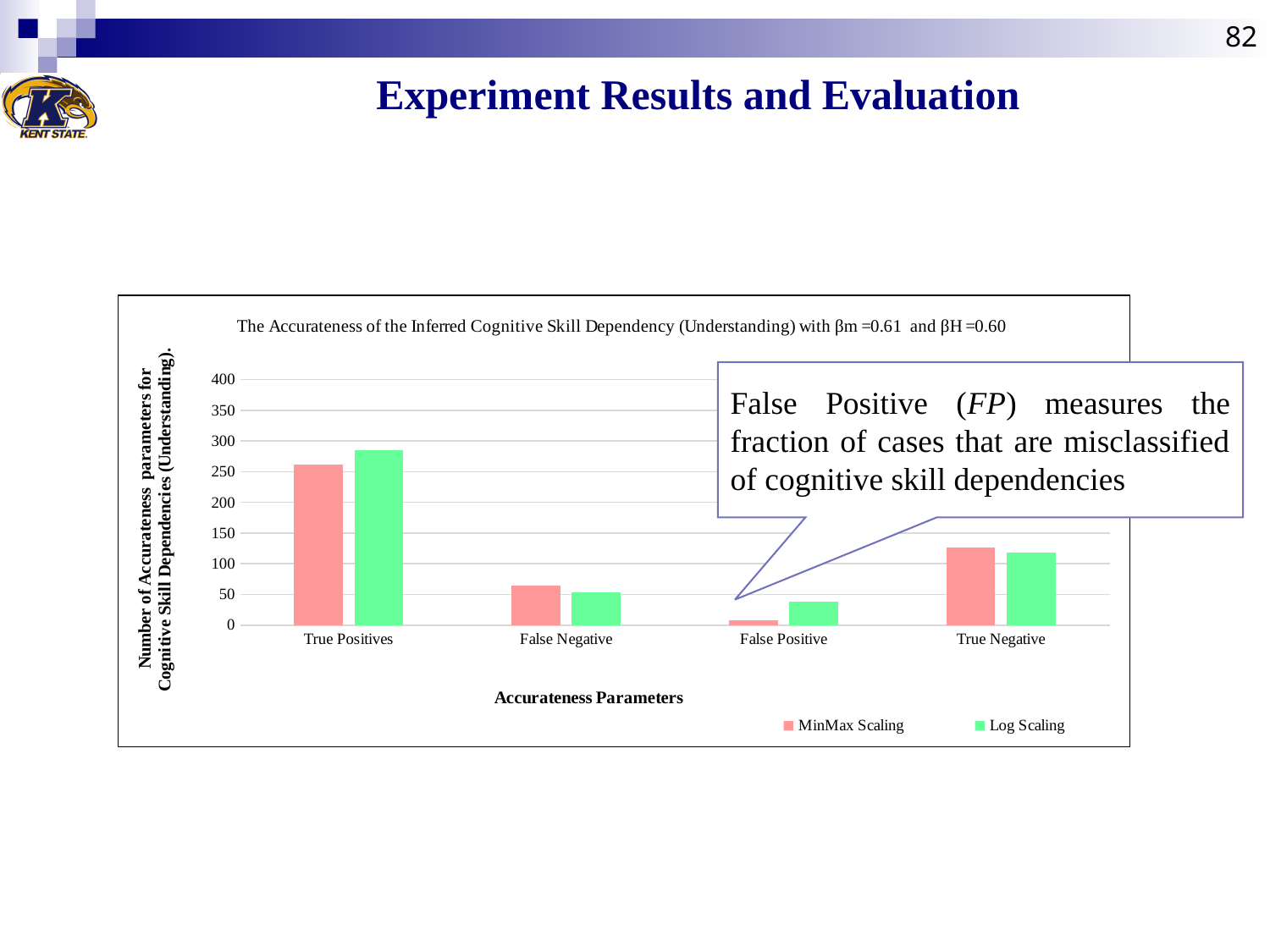
How many series does the chart's legend list? 2 For False Positive, which series has the larger value, MinMax Scaling or Log Scaling? Log Scaling Is the value for True Negative under MinMax Scaling greater or less than 100? greater For True Positives, which series has the larger value, MinMax Scaling or Log Scaling? Log Scaling Is the value for True Positives under Log Scaling greater or less than 250? greater Which category has the highest value for Log Scaling? True Positives What is the label of the x axis of the chart? Accurateness Parameters How many categories are shown on the x axis of the chart? 4 Which category has the lowest value for MinMax Scaling? False Positive Which category has the highest value for MinMax Scaling? True Positives Which category has the lowest value for Log Scaling? False Positive What kind of chart is shown on the slide? bar chart